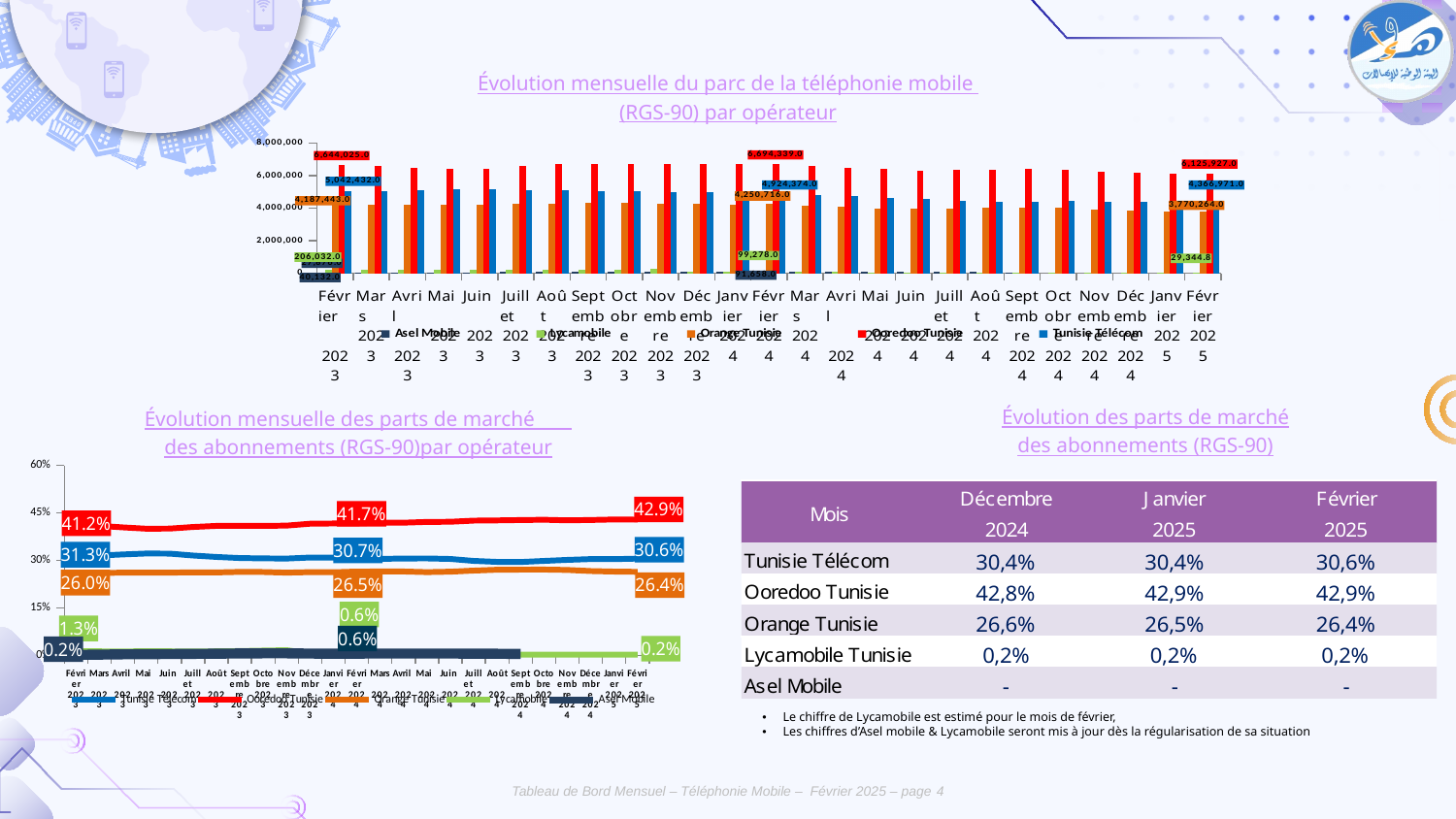
In the top chart 'Évolution mensuelle du parc de la téléphonie mobile', what is the difference between the Ooredoo Tunisie value in Février 2023 and in Février 2025? 518,098.0 In the bottom-left chart 'Évolution mensuelle des parts de marché des abonnements', does the Ooredoo Tunisie share rise or fall from Février 2023 to Février 2025? Rise In the bottom-left chart 'Évolution mensuelle des parts de marché des abonnements', is the Tunisie Télécom share larger in Février 2023 or in Février 2025? Février 2023 What kind of chart is the bottom-left chart titled 'Évolution mensuelle des parts de marché des abonnements (RGS-90) par opérateur'? Line chart In the top chart 'Évolution mensuelle du parc de la téléphonie mobile', is the value for Orange Tunisie in Février 2025 greater or less than 4,000,000? less In the bottom-left chart 'Évolution mensuelle des parts de marché des abonnements', what is the market share of Ooredoo Tunisie in Février 2025? 42.9% In the top chart 'Évolution mensuelle du parc de la téléphonie mobile', how many series does the legend list? 5 In the top chart 'Évolution mensuelle du parc de la téléphonie mobile', what is the value for Tunisie Télécom in Février 2023? 5,042,432.0 In the top chart 'Évolution mensuelle du parc de la téléphonie mobile', what is the value for Ooredoo Tunisie in Février 2025? 6,125,927.0 In the top chart 'Évolution mensuelle du parc de la téléphonie mobile', which operator has the highest value in Février 2025? Ooredoo Tunisie What kind of chart is the top chart titled 'Évolution mensuelle du parc de la téléphonie mobile (RGS-90) par opérateur'? Bar chart